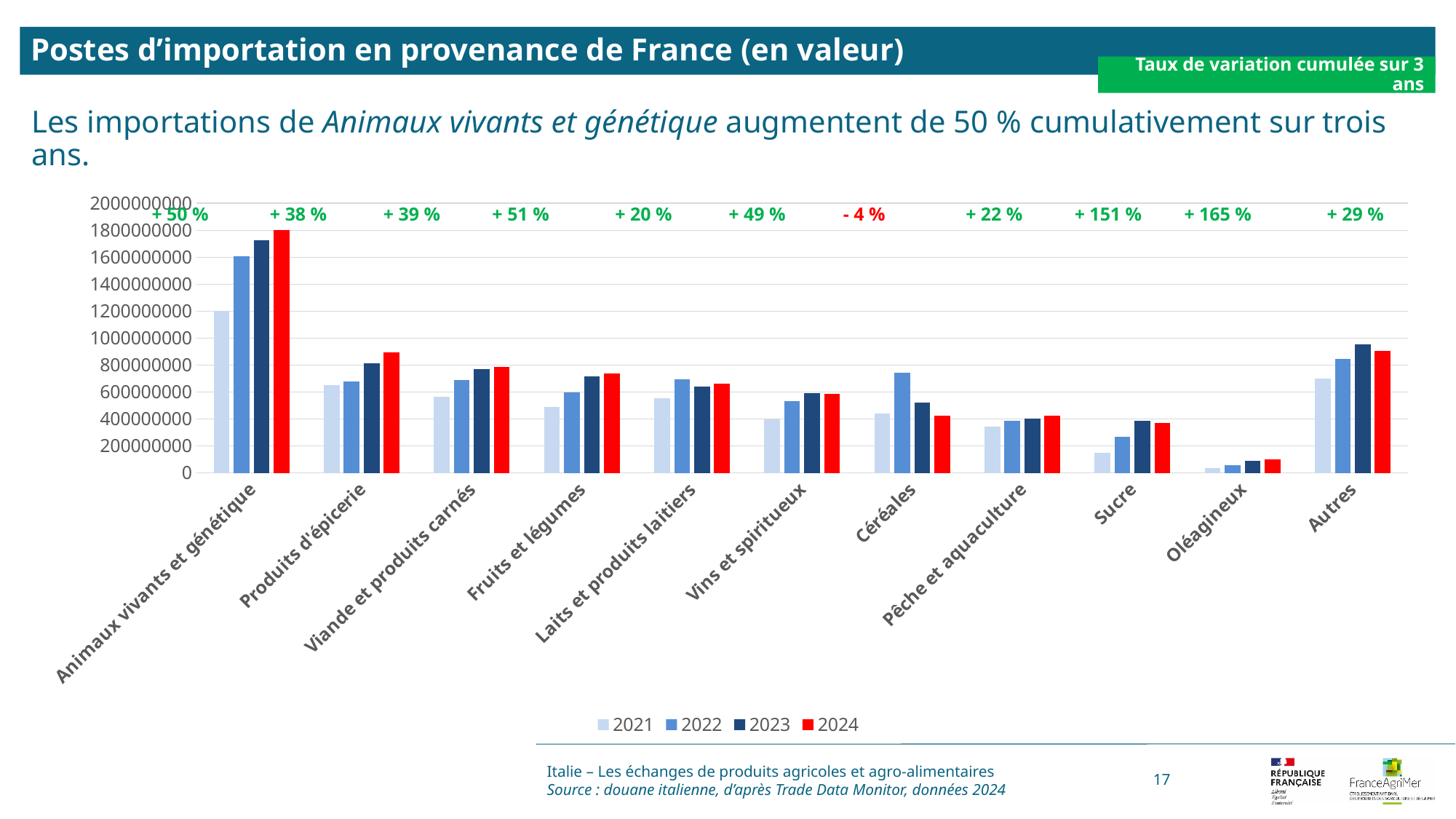
What is the cumulative variation rate over 3 years printed above Oléagineux? + 165 % Which category has the highest cumulative variation rate over 3 years? Oléagineux What is the cumulative variation rate over 3 years printed above Sucre? + 151 % How many product categories are shown on the x axis? 11 Is the 2024 value for Animaux vivants et génétique greater or less than 1600000000? greater Which category has the lowest cumulative variation rate over 3 years? Céréales How many series does the legend list? 4 Is the 2021 value for Sucre greater or less than 200000000? less What kind of chart is shown on the slide? bar chart What is the cumulative variation rate over 3 years printed above Céréales? - 4 % Which colour represents the 2024 series in the legend? red For Céréales, which is larger: the 2022 value or the 2024 value? 2022